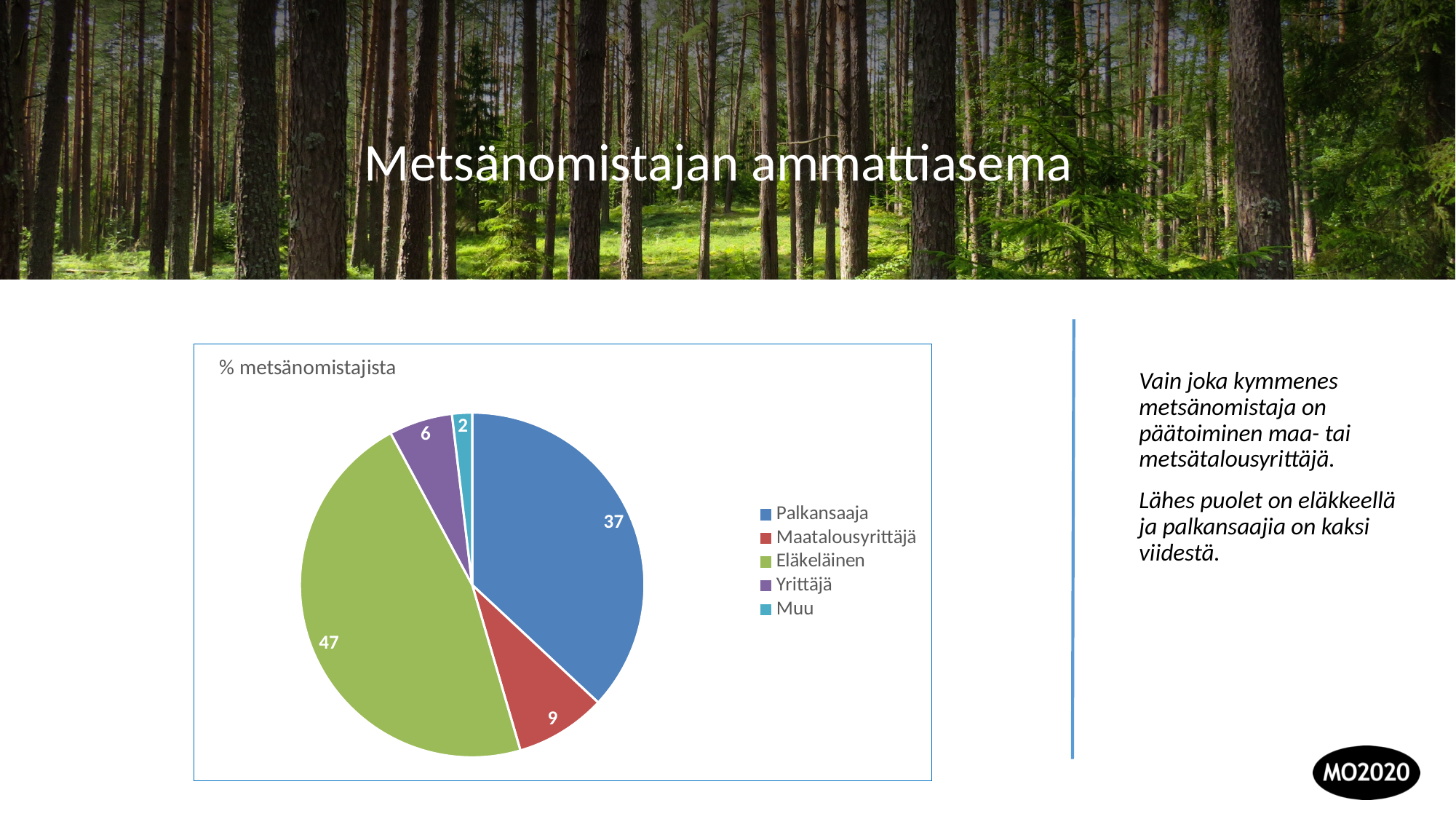
What is the title shown inside the chart area? % metsänomistajista What type of chart is shown on the slide? pie chart What is the difference between the values for Eläkeläinen and Palkansaaja? 10 What is the value for Palkansaaja? 37 Which category has the largest slice? Eläkeläinen Which category has the smallest slice? Muu How many categories does the legend list? 5 What is the value for Muu? 2 What is the value for Eläkeläinen? 47 What is the value for Yrittäjä? 6 What is the value for Maatalousyrittäjä? 9 Which is larger, Maatalousyrittäjä or Yrittäjä? Maatalousyrittäjä